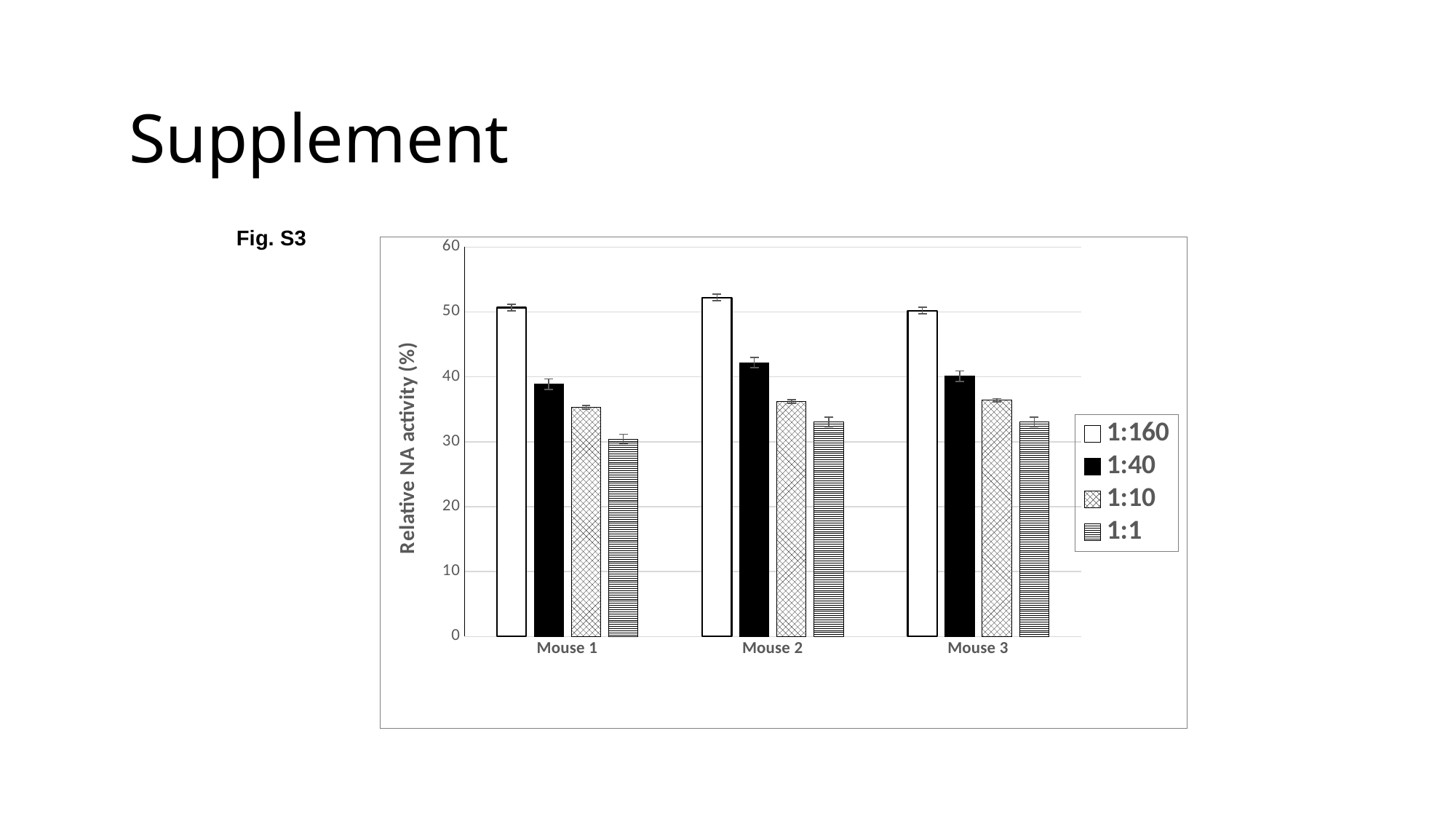
What kind of chart is shown on the slide? bar chart Which mouse has the highest 1:160 value? Mouse 2 Is the 1:40 value for Mouse 2 greater or less than 40? greater What is the y-axis label of the chart? Relative NA activity (%) Which series has the lowest value for Mouse 1? 1:1 Which is larger, the 1:40 value for Mouse 1 or the 1:40 value for Mouse 2? Mouse 2 Is the 1:1 value for Mouse 2 greater or less than 30? greater Is the 1:160 value for Mouse 2 greater or less than 50? greater How many mouse categories are shown on the x axis? 3 Which series is drawn with solid black bars? 1:40 How many series does the legend list? 4